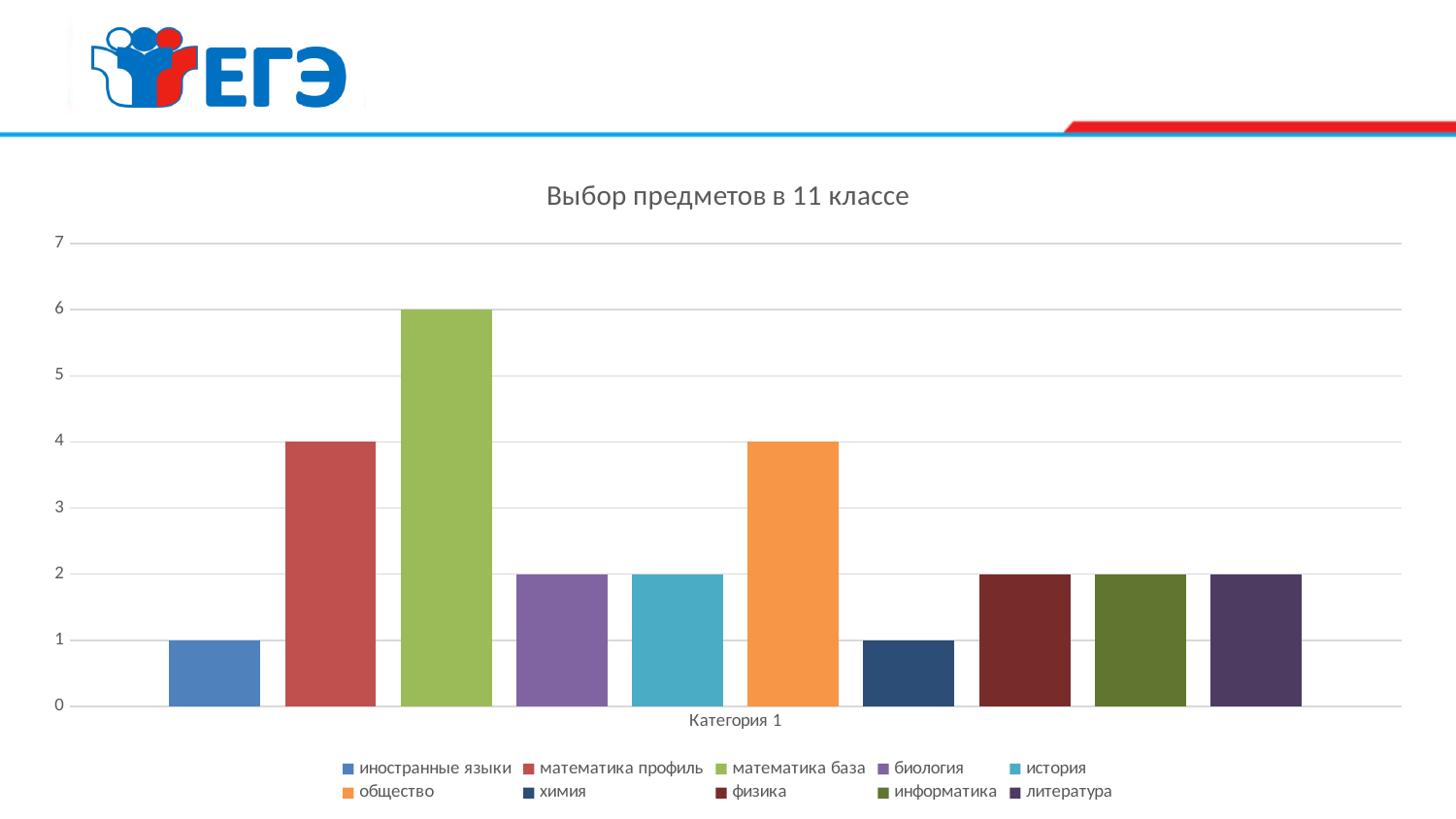
What is the value for иностранные языки? 1 Which series has the highest value? математика база What is the title of the chart? Выбор предметов в 11 классе How many series does the legend list? 10 What is the difference between the values for математика база and математика профиль? 2 Which is larger, the value for биология or the value for химия? биология Is the value for математика база greater or less than 5? greater What type of chart is shown on the slide? bar chart What is the value for общество? 4 What is the value for математика база? 6 What is the label of the category on the x axis? Категория 1 What is the value for математика профиль? 4